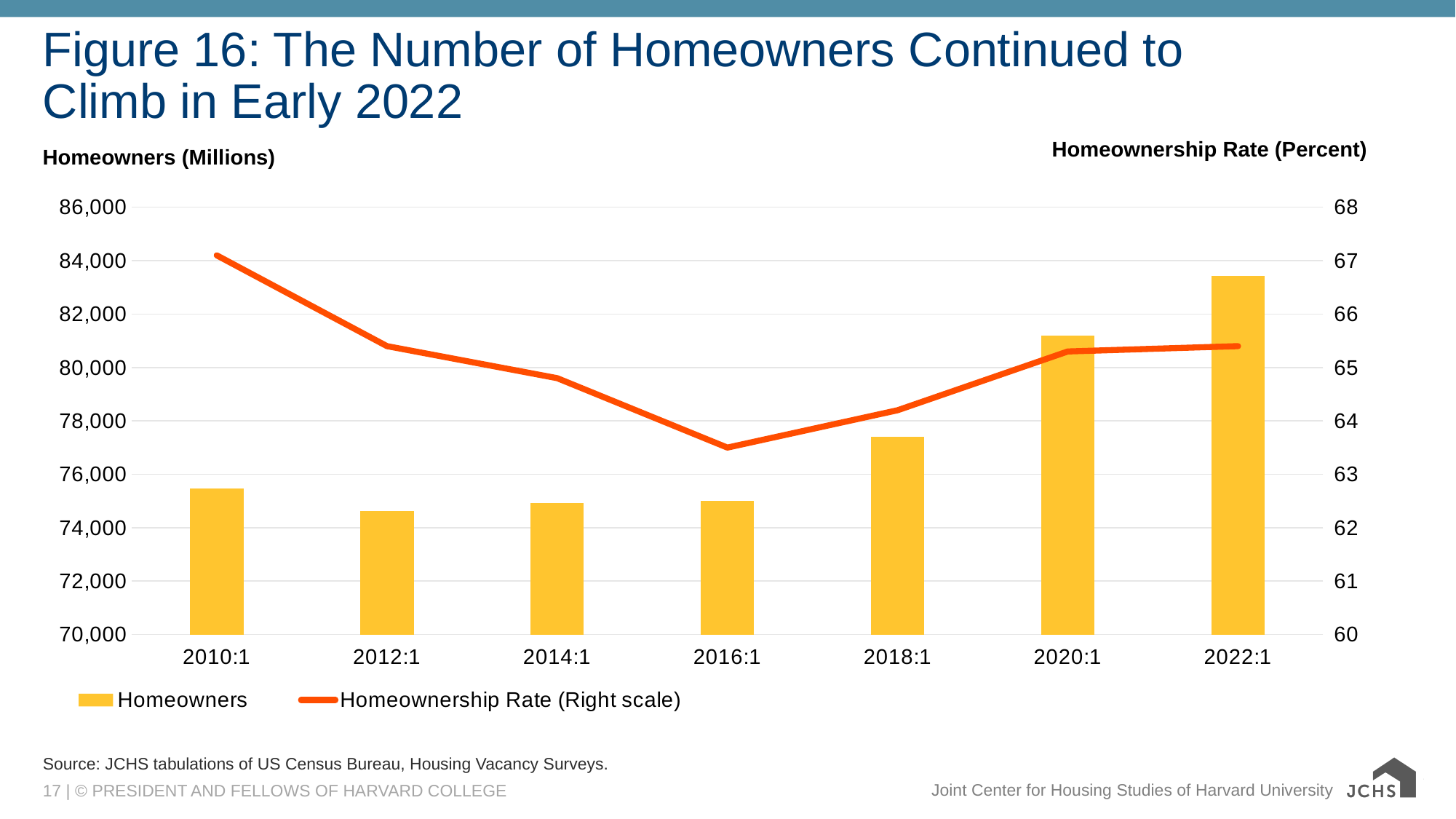
What kind of chart is shown on the slide? A combined bar and line chart Does the homeownership rate rise or fall from 2010:1 to 2016:1? fall In which period is the number of homeowners highest? 2022:1 What is the label of the left vertical axis? Homeowners (Millions) Which period has more homeowners, 2018:1 or 2020:1? 2020:1 In which period is the homeownership rate lowest? 2016:1 How many time periods are shown on the x axis? 7 How many series does the legend list? 2 In which period is the homeownership rate highest? 2010:1 Is the homeownership rate in 2016:1 greater or less than 64? less Is the number of homeowners in 2020:1 greater or less than 80,000? greater Is the number of homeowners in 2022:1 greater or less than 82,000? greater